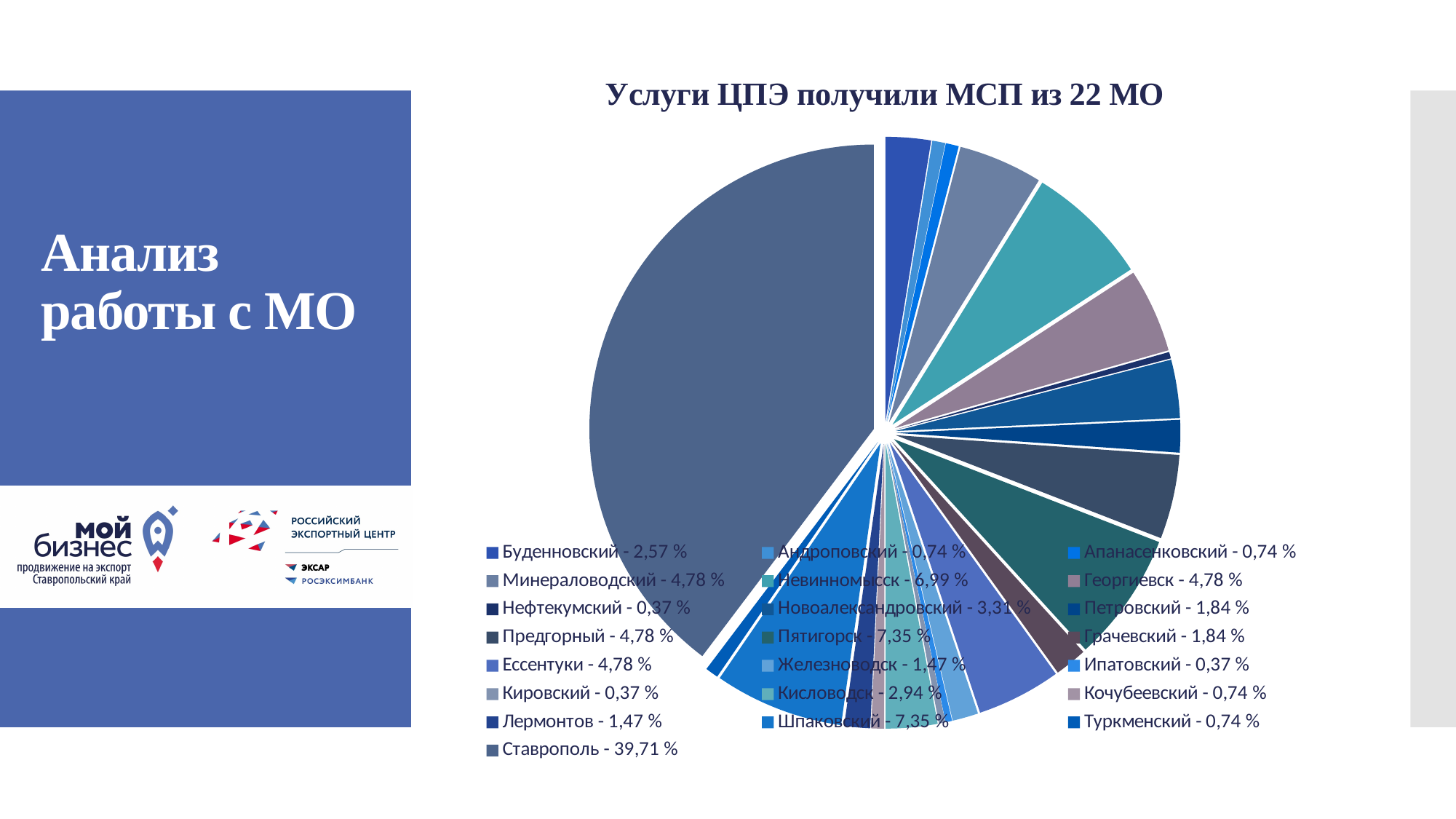
How many categories does the pie chart's legend list? 22 What is the difference between the share for Ставрополь and the share for Шпаковский? 32,36 % What share of the pie does Ставрополь have? 39,71 % Which is larger, the share for Пятигорск or the share for Невинномысск? Пятигорск What is the value shown for Невинномысск? 6,99 % What is the value shown for Новоалександровский? 3,31 % What is the difference between the share for Минераловодский and the share for Петровский? 2,94 % What is the value shown for Буденновский? 2,57 % What is the title of the chart? Услуги ЦПЭ получили МСП из 22 МО Which category has the largest share of the pie? Ставрополь What kind of chart is shown on the slide? pie chart What is the value shown for Кисловодск? 2,94 %